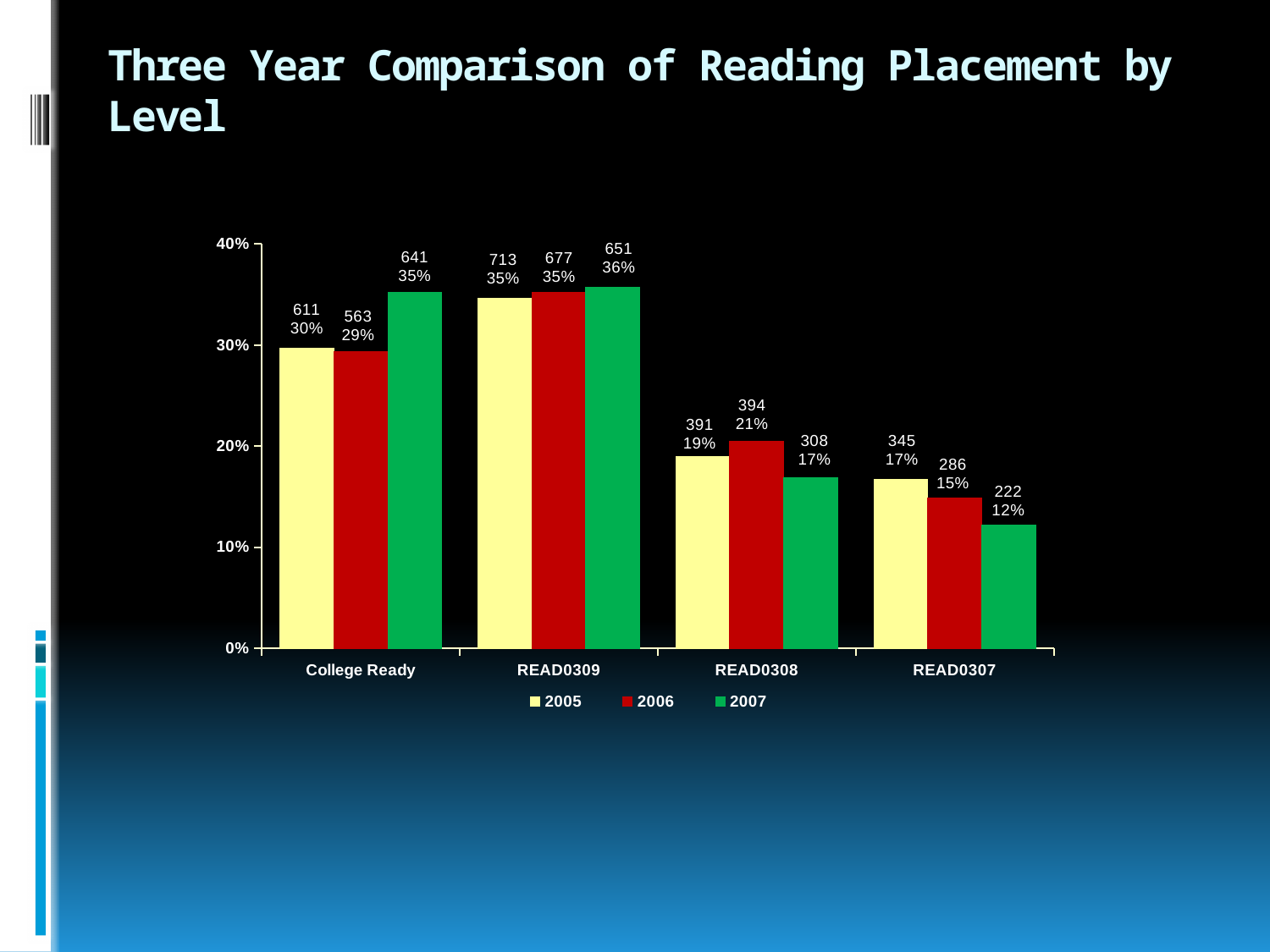
What percentage is shown for College Ready in 2007? 35% What count is shown for READ0309 in 2005? 713 Which category has the lowest percentage for 2007? READ0307 What is the title of the chart? Three Year Comparison of Reading Placement by Level What is the difference in count between READ0308 in 2006 and READ0308 in 2007? 86 Which category has the highest percentage for 2006? READ0309 What kind of chart is shown on the slide? Bar chart How many categories are shown on the x axis? 4 Which is larger: the 2005 percentage for College Ready or the 2005 percentage for READ0308? College Ready How many series does the legend list? 3 Does the percentage for READ0307 rise or fall from 2005 to 2007? Fall What percentage is shown for READ0307 in 2006? 15%